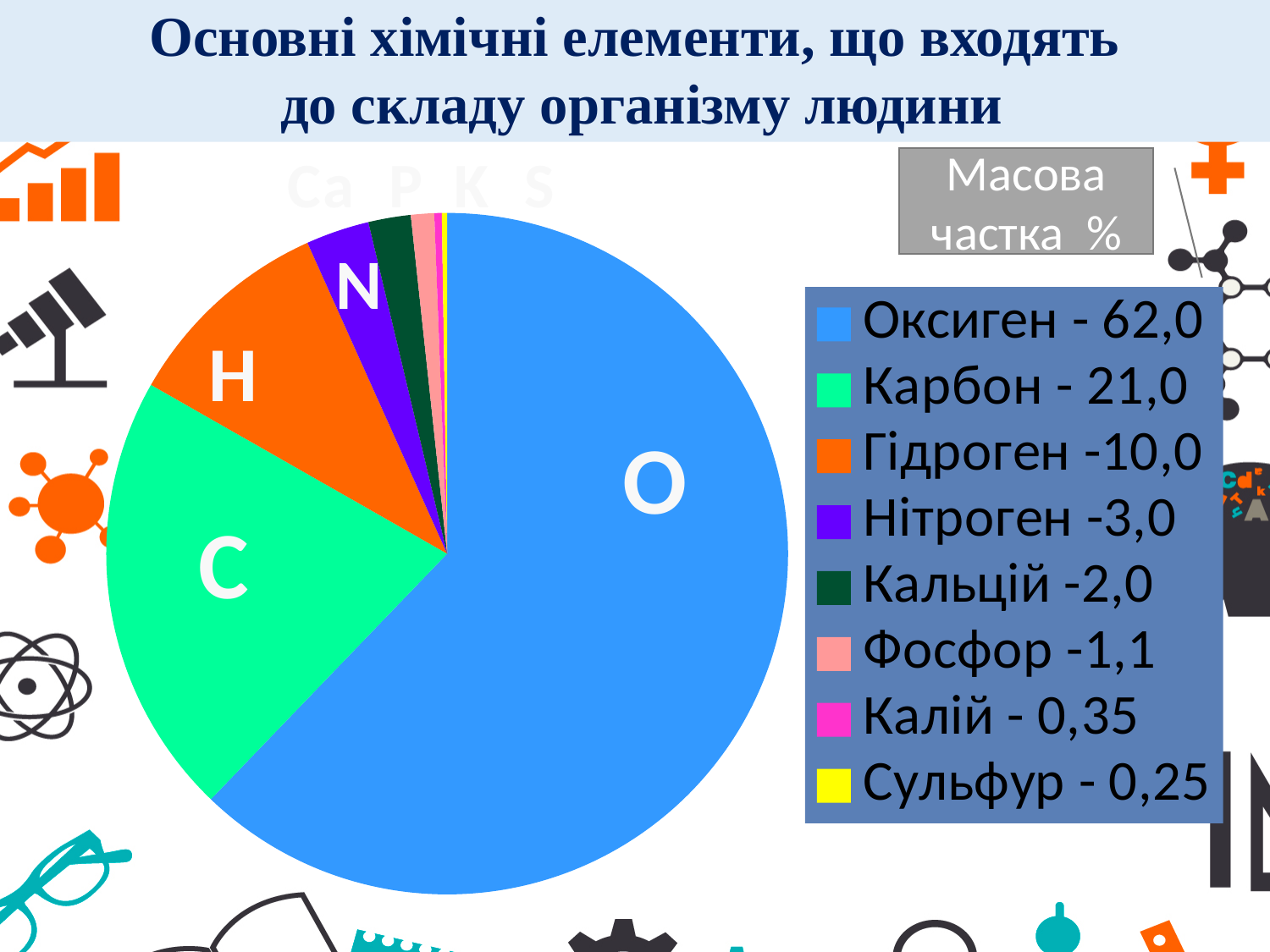
What is the difference between the values for Гідроген and Нітроген? 7,0 What is the value for Калій in the legend? 0,35 What colour is the slice for Сульфур? yellow Which is larger, the value for Кальцій or the value for Фосфор? Кальцій How many elements are listed in the legend of the pie chart? 8 Which element has the smallest value in the legend? Сульфур What is the value for Карбон in the legend? 21,0 Which element has the largest slice of the pie? Оксиген What is the value for Гідроген in the legend? 10,0 What type of chart is shown on the slide? pie chart What is the value for Оксиген in the legend? 62,0 What is the difference between the values for Оксиген and Карбон? 41,0